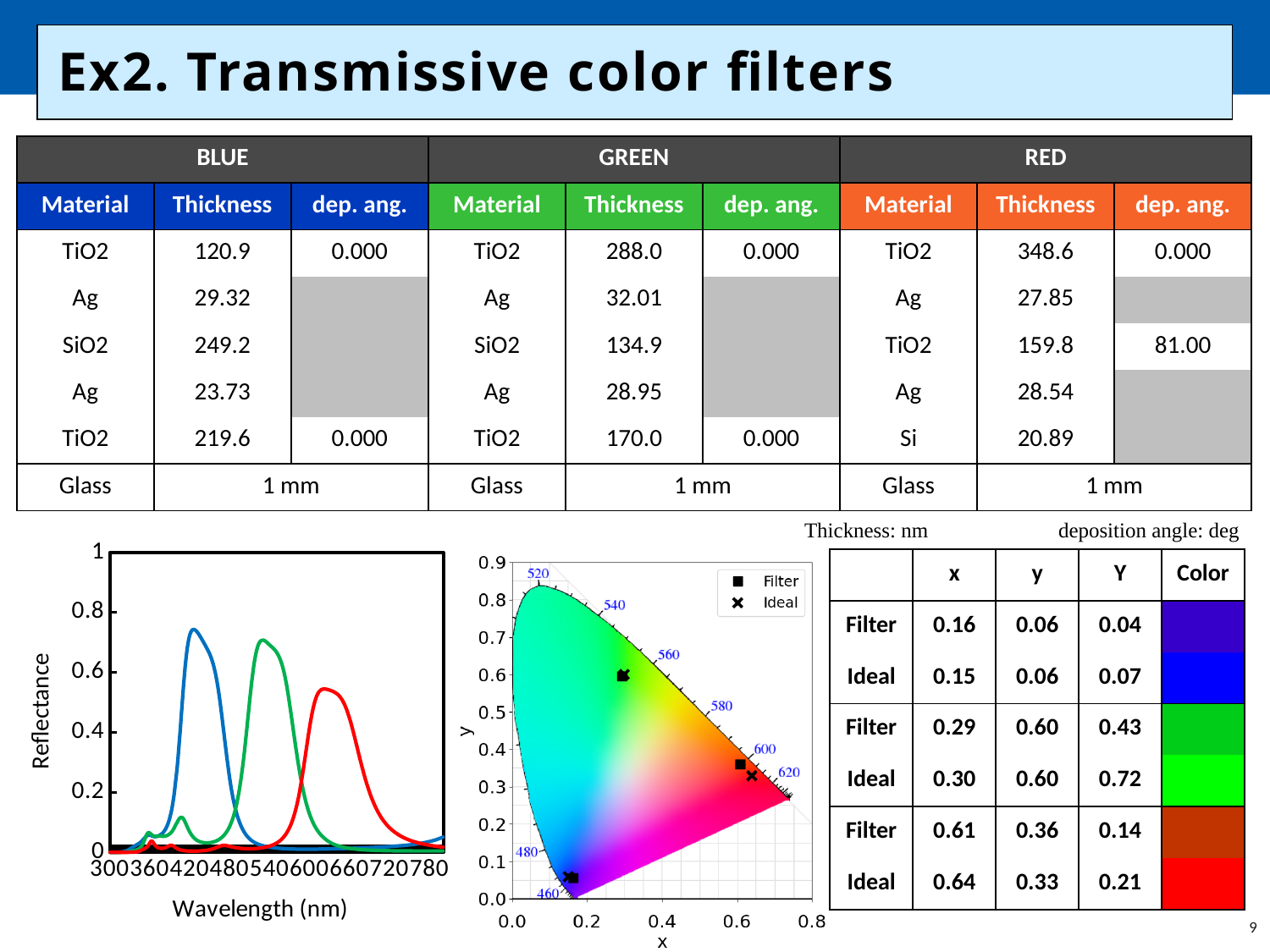
In the chromaticity chart on the right, is the y value of the Filter point near the 600 nm edge greater or less than 0.4? less In the left Reflectance chart, how many curves are plotted? 3 In the left Reflectance chart, is the peak value of the red curve greater or less than 0.6? less In the left Reflectance chart, is the peak value of the red curve greater or less than 0.4? greater In the chromaticity chart on the right, how many series does the legend list? 2 In the left Reflectance chart, which curve has the lowest peak reflectance? red In the left Reflectance chart, which has a higher peak reflectance, the blue curve or the red curve? blue In the left Reflectance chart, what is the label of the x axis? Wavelength (nm) What kind of chart is the left chart with Reflectance on the y axis? line chart In the chromaticity chart on the right, what are the two legend entries? Filter, Ideal